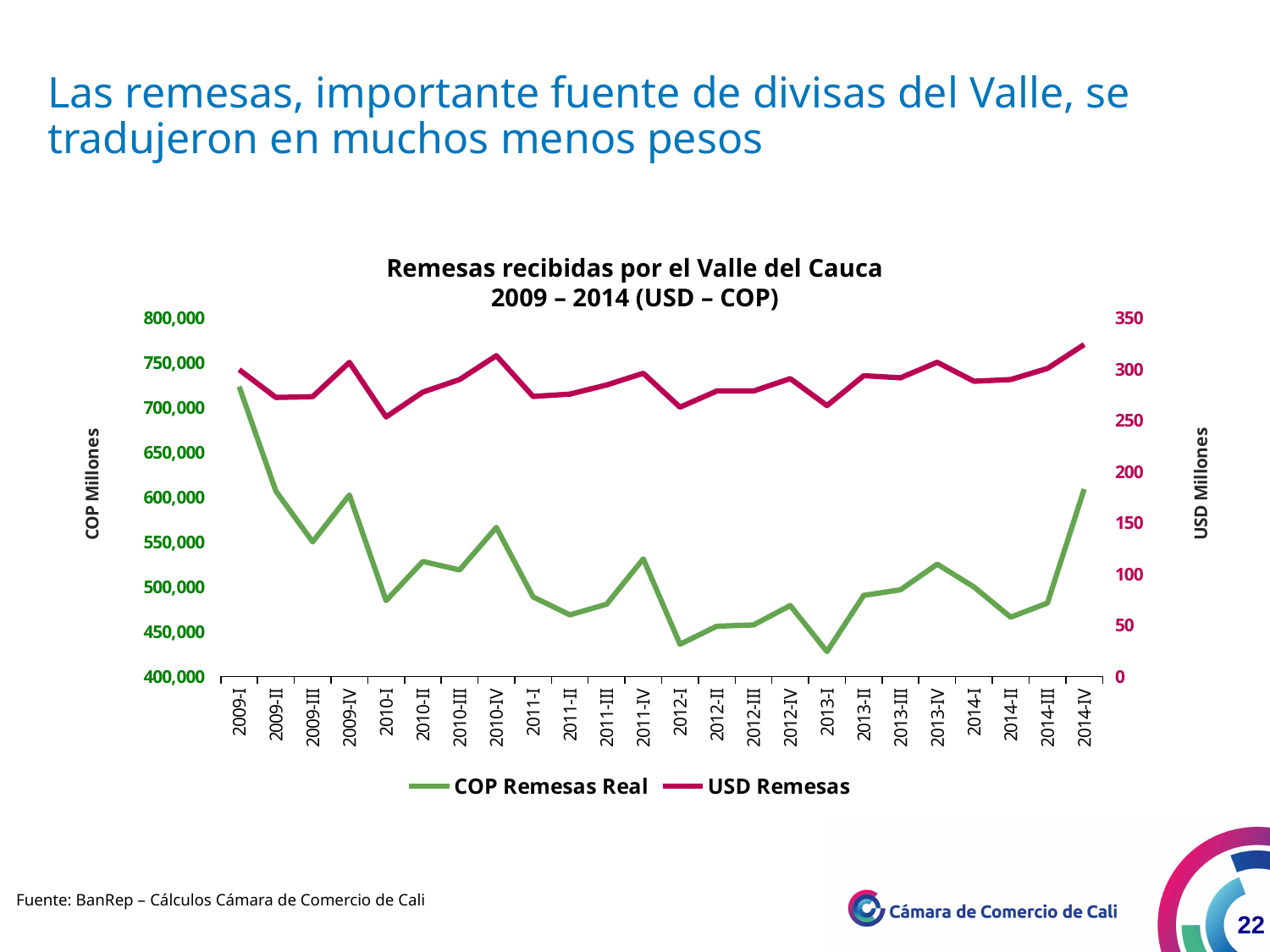
In which quarter is the USD Remesas series at its highest? 2014-IV Is the COP Remesas Real value for 2009-I greater or less than 700,000? greater What is the title of the chart? Remesas recibidas por el Valle del Cauca 2009 – 2014 (USD – COP) What kind of chart is shown on the slide? Line chart How many quarters are plotted along the x axis? 24 How many series does the legend list? 2 Is the USD Remesas value for 2010-I greater or less than 300? less Is the COP Remesas Real value for 2013-I greater or less than 450,000? less What is the label of the right-hand vertical axis? USD Millones Does the COP Remesas Real series rise or fall from 2009-I to 2010-I? Fall In which quarter is the COP Remesas Real series at its highest? 2009-I Which is larger, the COP Remesas Real value for 2009-I or for 2013-I? 2009-I